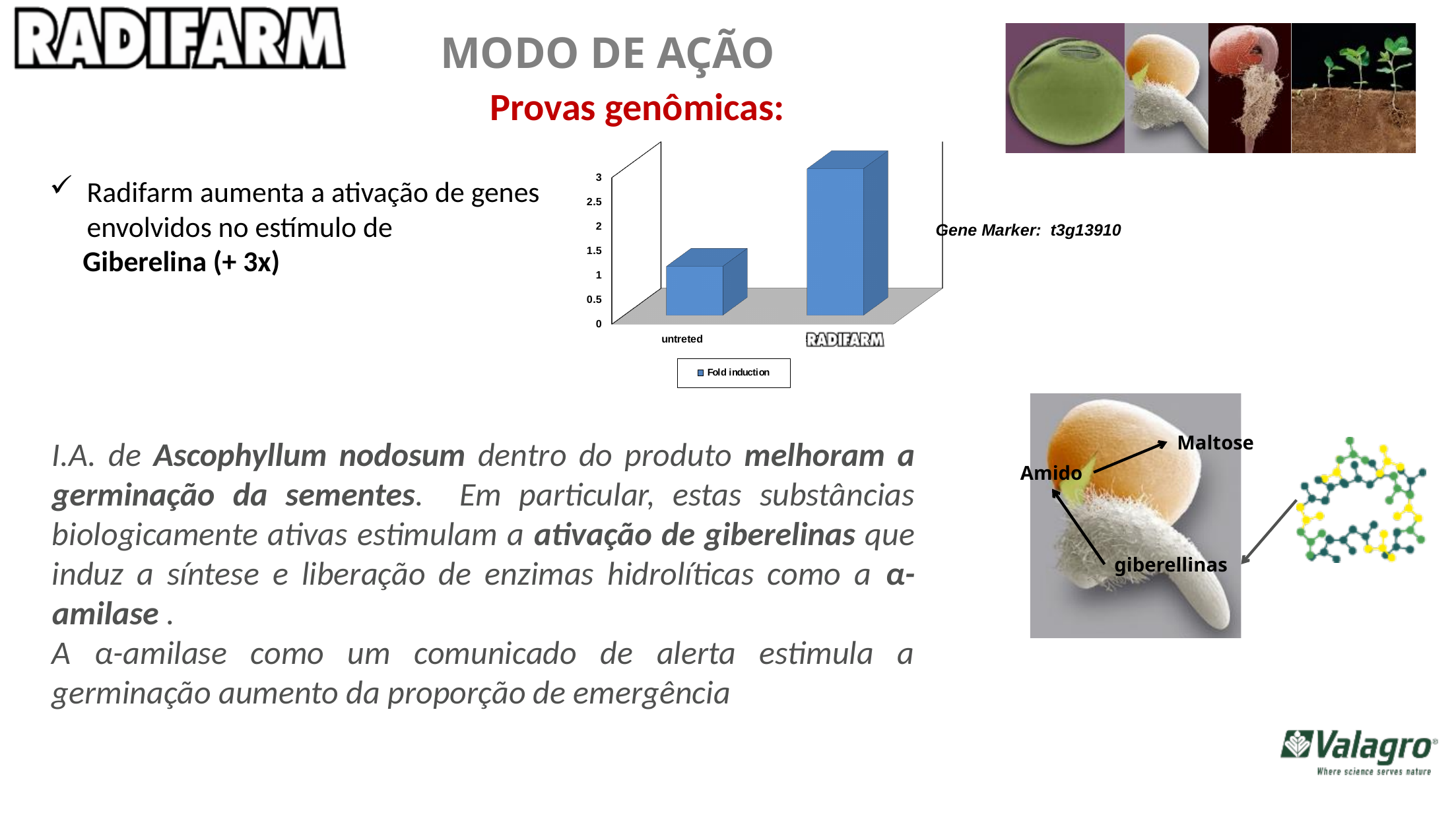
What kind of chart is shown on the slide? bar chart Does the fold induction rise or fall from untreted to RADIFARM along the x axis? rise Which has a larger fold induction, untreted or RADIFARM? RADIFARM Is the fold induction value for untreted greater or less than 2? less Which category has the lowest fold induction in the chart? untreted Which category has the highest fold induction in the chart? RADIFARM Is the fold induction value for untreted greater or less than 0.5? greater How many categories are plotted on the x axis of the chart? 2 How many series does the chart legend list? 1 Which gene marker is named next to the chart? t3g13910 Is the fold induction value for RADIFARM greater or less than 2? greater What is the name of the series shown in the chart legend? Fold induction